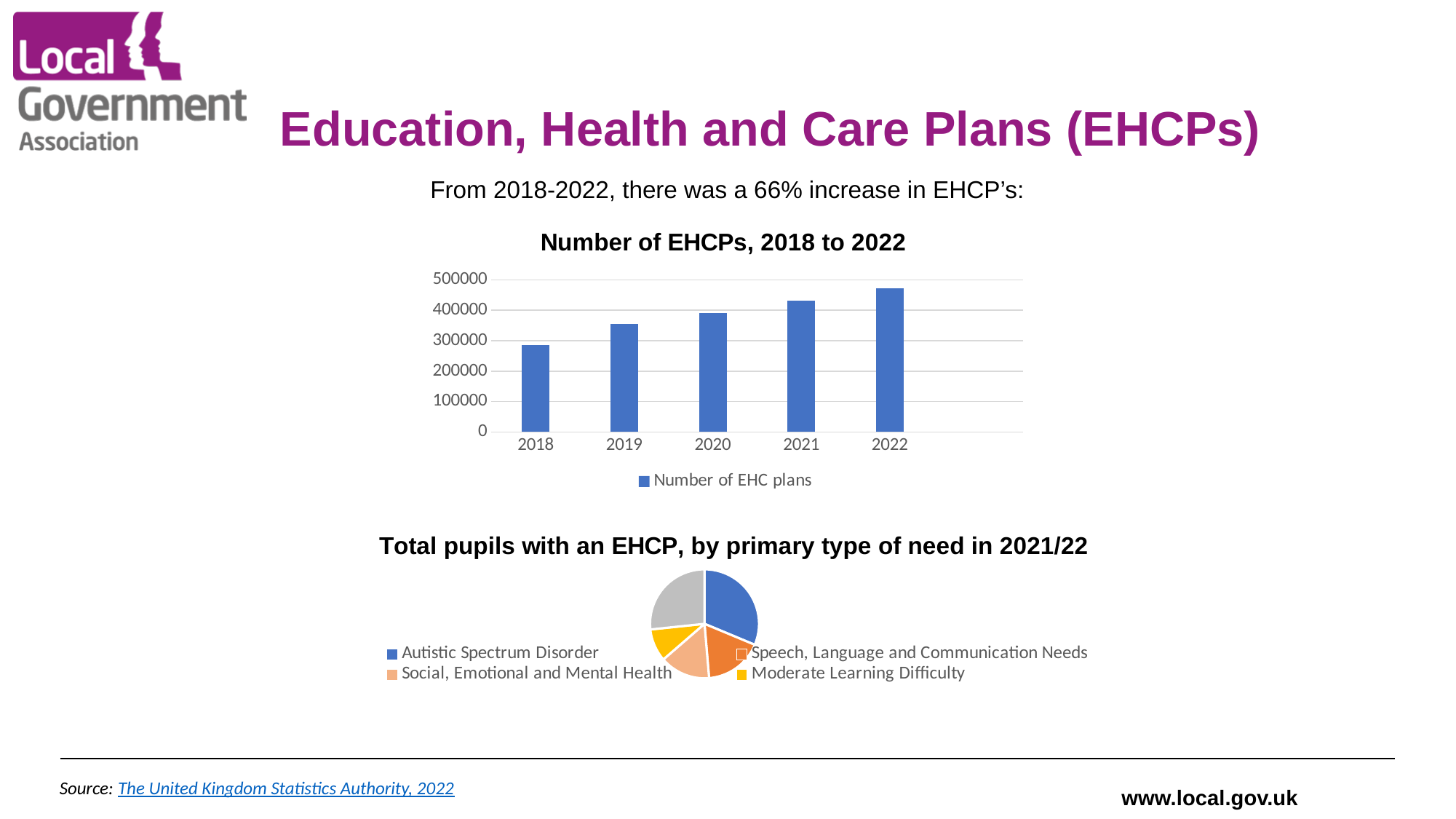
In the chart titled 'Number of EHCPs, 2018 to 2022', is the value for 2022 greater or less than 400000? greater In the chart titled 'Total pupils with an EHCP, by primary type of need in 2021/22', how many entries does the legend list? 4 In the chart titled 'Total pupils with an EHCP, by primary type of need in 2021/22', what kind of chart is shown? pie chart In the chart titled 'Number of EHCPs, 2018 to 2022', which year has the highest number of EHC plans? 2022 In the chart titled 'Number of EHCPs, 2018 to 2022', do the values rise or fall from 2018 to 2022? rise In the chart titled 'Number of EHCPs, 2018 to 2022', what kind of chart is shown? bar chart In the chart titled 'Number of EHCPs, 2018 to 2022', which year has the lowest number of EHC plans? 2018 In the chart titled 'Number of EHCPs, 2018 to 2022', how many series does the legend list? 1 In the chart titled 'Number of EHCPs, 2018 to 2022', is the value for 2018 greater or less than 300000? less In the chart titled 'Number of EHCPs, 2018 to 2022', is the value for 2019 greater or less than 300000? greater In the chart titled 'Total pupils with an EHCP, by primary type of need in 2021/22', which is larger: Autistic Spectrum Disorder or Moderate Learning Difficulty? Autistic Spectrum Disorder In the chart titled 'Number of EHCPs, 2018 to 2022', how many years are plotted? 5